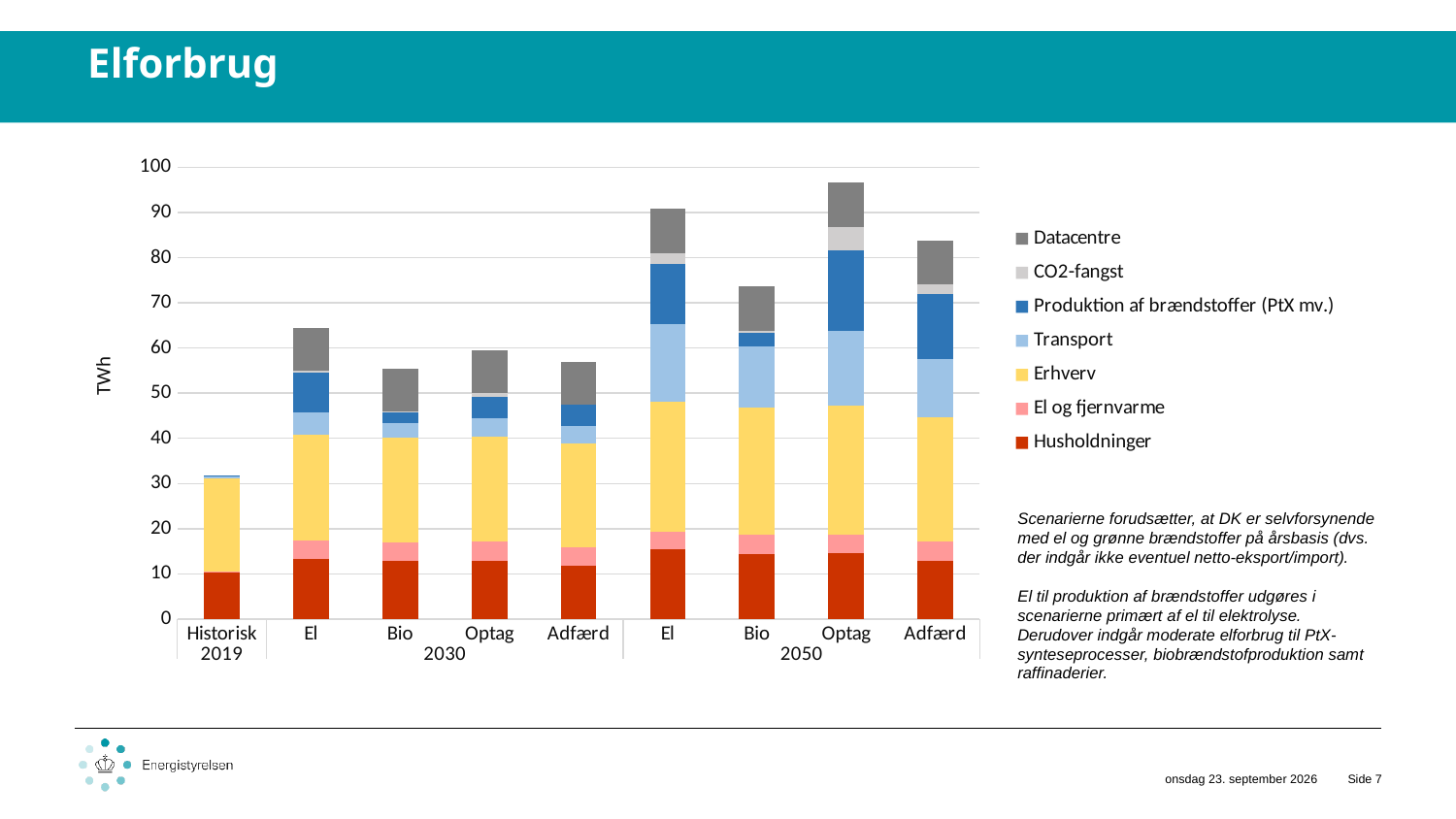
How many series does the legend list? 7 Which has a larger total: El in 2030 or El in 2050? El in 2050 Is the total for El in 2030 greater or less than 60 TWh? greater Is the total for Optag in 2050 greater or less than 90 TWh? greater Which bar has the lowest total electricity consumption? Historisk 2019 Which series is shown in dark grey at the top of the stacked bars? Datacentre Is the total for Bio in 2030 greater or less than 60 TWh? less What unit is shown on the y-axis? TWh Which bar has the highest total electricity consumption? Optag (2050) What kind of chart is shown on the slide? Stacked bar chart How many bars are plotted in the chart? 9